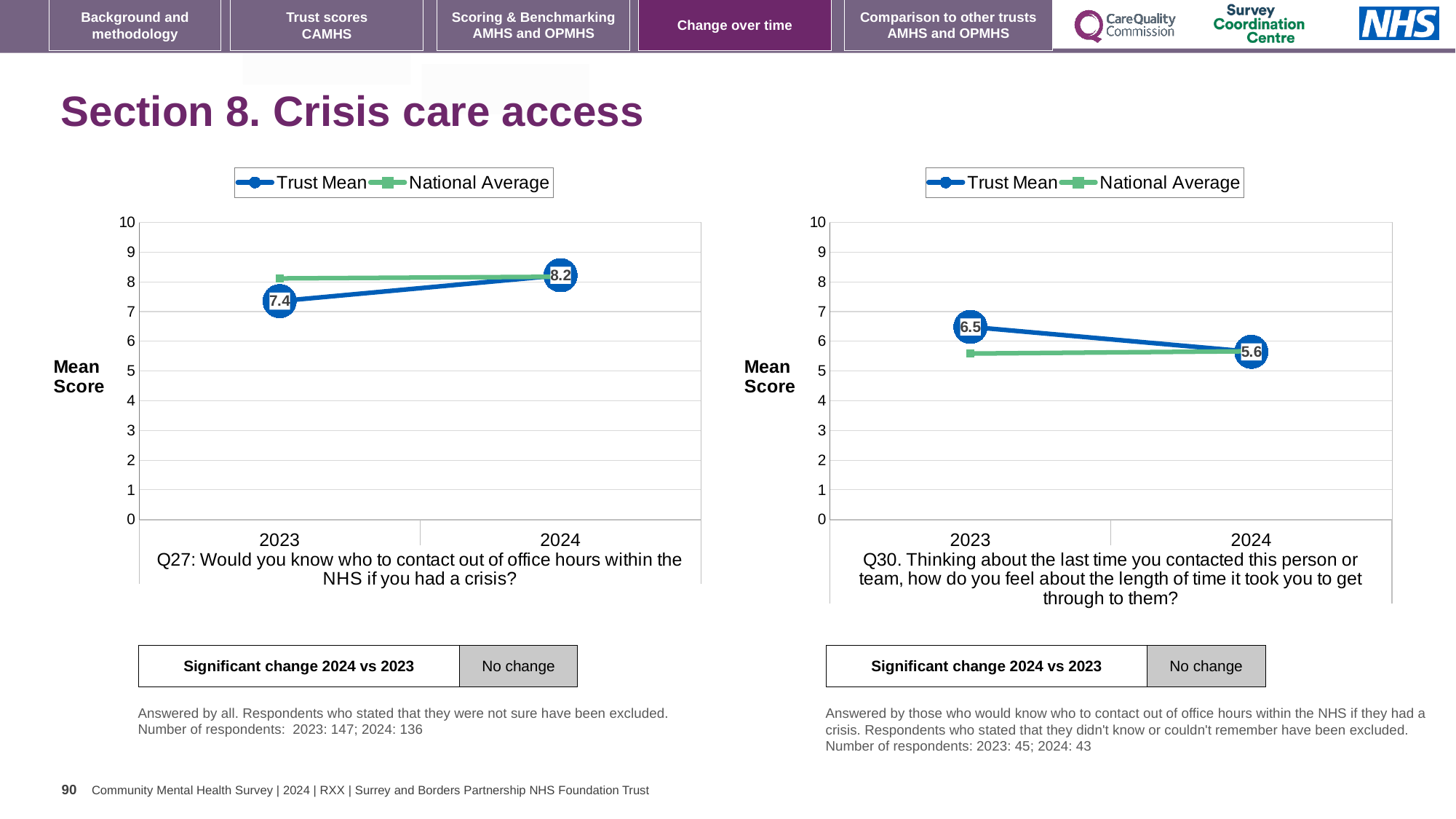
In the Q27 chart on the left, what is the Trust Mean score for 2024? 8.2 In the Q30 chart on the right, does the Trust Mean rise or fall from 2023 to 2024? fall What kind of chart is the Q27 chart on the left? line chart In the Q30 chart on the right, is the National Average for 2023 greater or less than 6? less In the Q30 chart on the right, what is the Trust Mean score for 2023? 6.5 In the Q27 chart on the left, by how much did the Trust Mean change from 2023 to 2024? 0.8 In the Q27 chart on the left, does the Trust Mean rise or fall from 2023 to 2024? rise In the Q30 chart on the right, what is the Trust Mean score for 2024? 5.6 How many series does the legend of the Q30 chart on the right list? 2 In the Q27 chart on the left, what is the Trust Mean score for 2023? 7.4 In the Q27 chart on the left, which is larger in 2023: the Trust Mean or the National Average? National Average In the Q30 chart on the right, by how much did the Trust Mean change from 2023 to 2024? 0.9